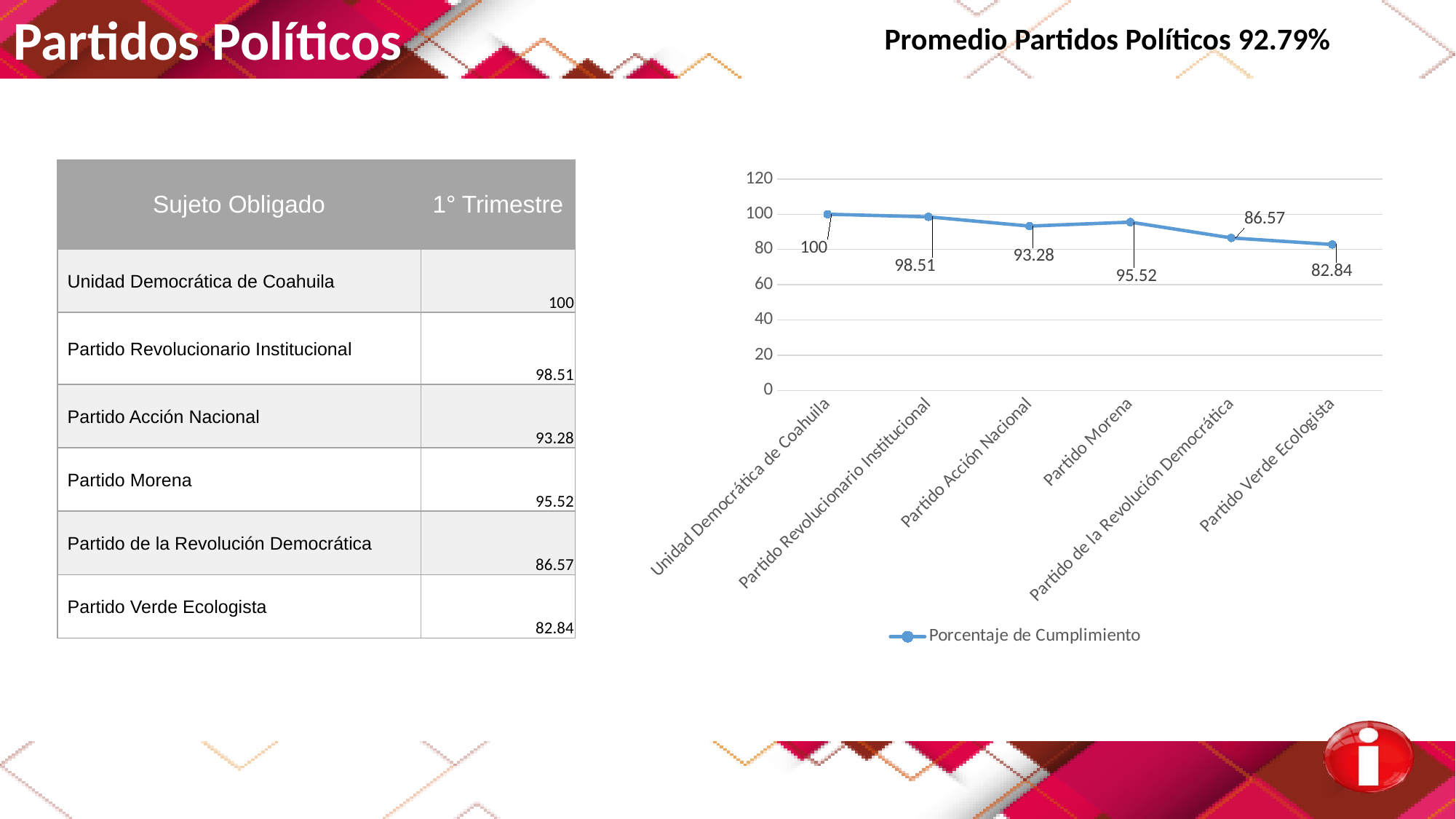
What is the difference between the values for Partido Revolucionario Institucional and Partido Acción Nacional? 5.23 Is the value for Partido Verde Ecologista greater or less than 100? less What is the value for Partido Morena in the chart? 95.52 What series name does the chart legend show? Porcentaje de Cumplimiento How many categories are plotted in the chart? 6 Which is larger, the value for Partido Morena or the value for Partido de la Revolución Democrática? Partido Morena Which category has the lowest value in the chart? Partido Verde Ecologista What kind of chart is shown on the slide? line chart What is the value for Partido de la Revolución Democrática in the chart? 86.57 What is the value for Partido Acción Nacional in the chart? 93.28 What is the difference between the values for Unidad Democrática de Coahuila and Partido Verde Ecologista? 17.16 Which category has the highest value in the chart? Unidad Democrática de Coahuila